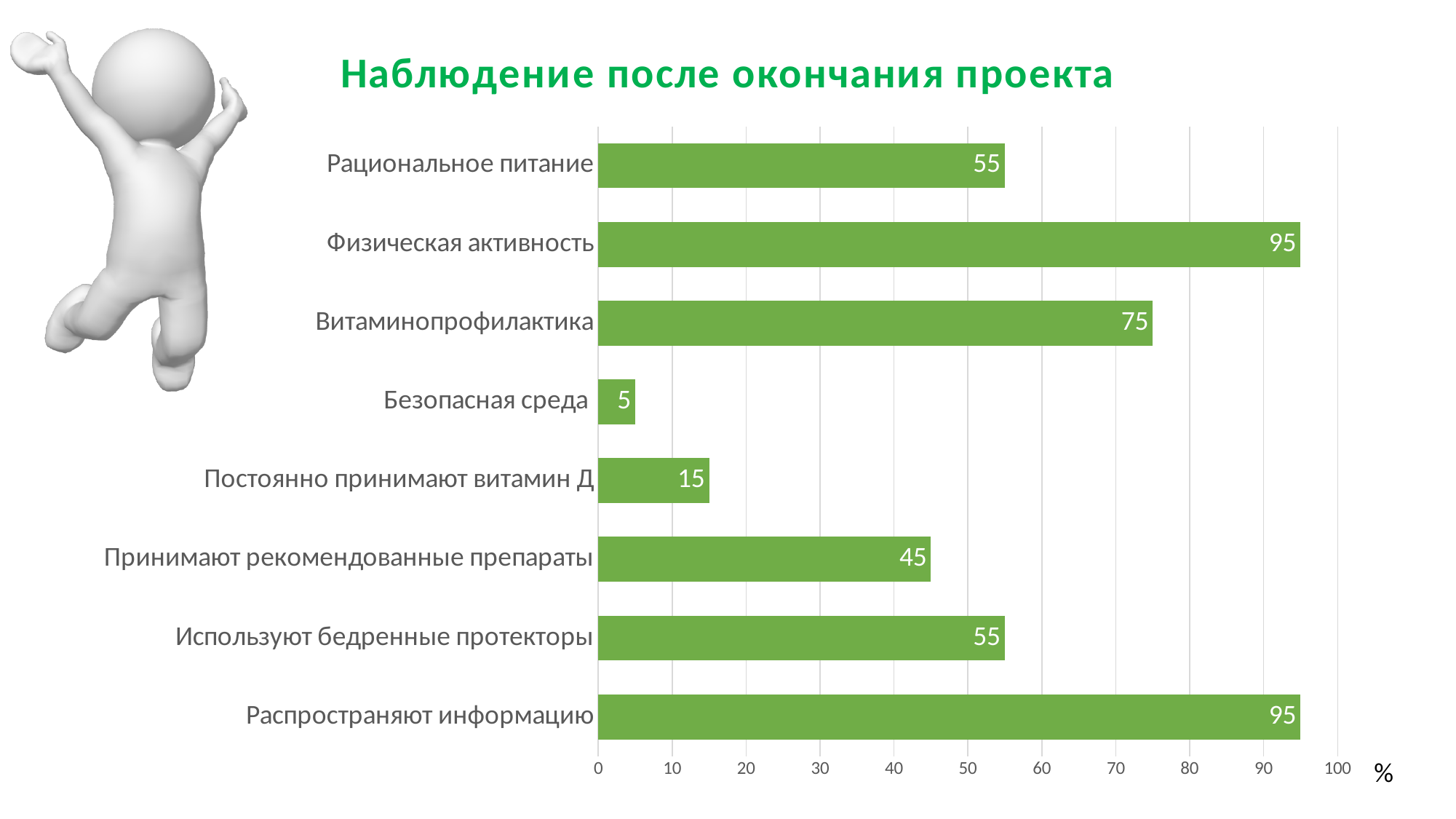
Which is larger, the value for Используют бедренные протекторы or the value for Постоянно принимают витамин Д? Используют бедренные протекторы What is the value for Постоянно принимают витамин Д? 15 Which category has the lowest value? Безопасная среда What is the value for Принимают рекомендованные препараты? 45 What is the difference between the values for Физическая активность and Рациональное питание? 40 How many categories are shown in the chart? 8 Is the value for Распространяют информацию greater or less than 90? greater What kind of chart is shown on the slide? bar chart What is the value for Безопасная среда? 5 What is the value for Витаминопрофилактика? 75 What is the difference between the values for Витаминопрофилактика and Принимают рекомендованные препараты? 30 What is the title of the chart? Наблюдение после окончания проекта